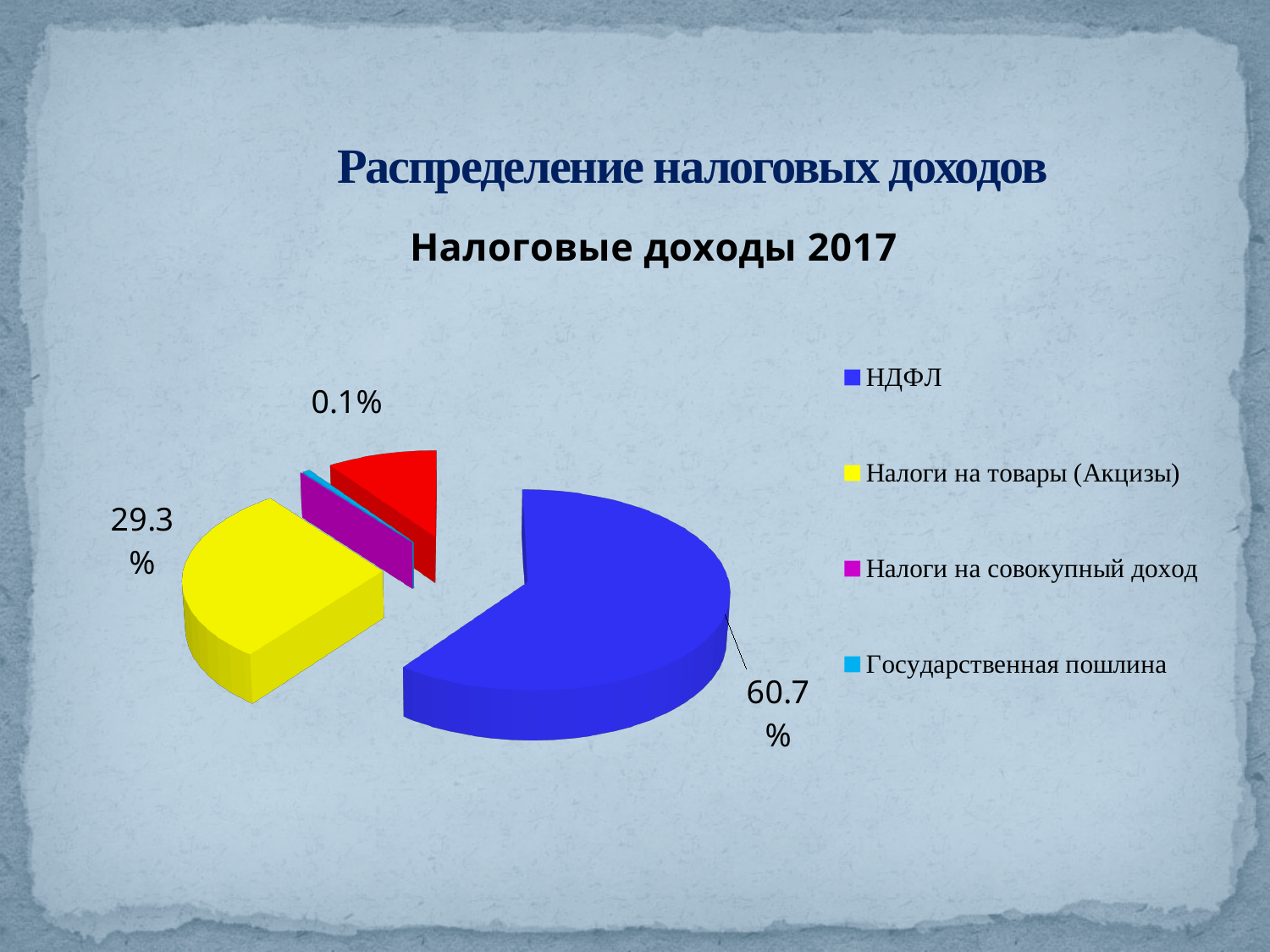
What share of the pie does Налоги на товары (Акцизы) account for? 29.3% What is the title of the chart? Налоговые доходы 2017 What share of the pie does НДФЛ account for? 60.7% Does the НДФЛ slice make up more or less than half of the pie? More By how many percentage points does the НДФЛ share exceed the Налоги на товары (Акцизы) share? 31.4 percentage points How many entries does the legend list? 4 What kind of chart is shown on the slide? Pie chart Which legend category has the smallest slice of the pie? Налоги на совокупный доход Which category has the largest slice of the pie? НДФЛ What colour is the slice for НДФЛ? Blue Which is larger: the slice for НДФЛ or the slice for Налоги на товары (Акцизы)? НДФЛ